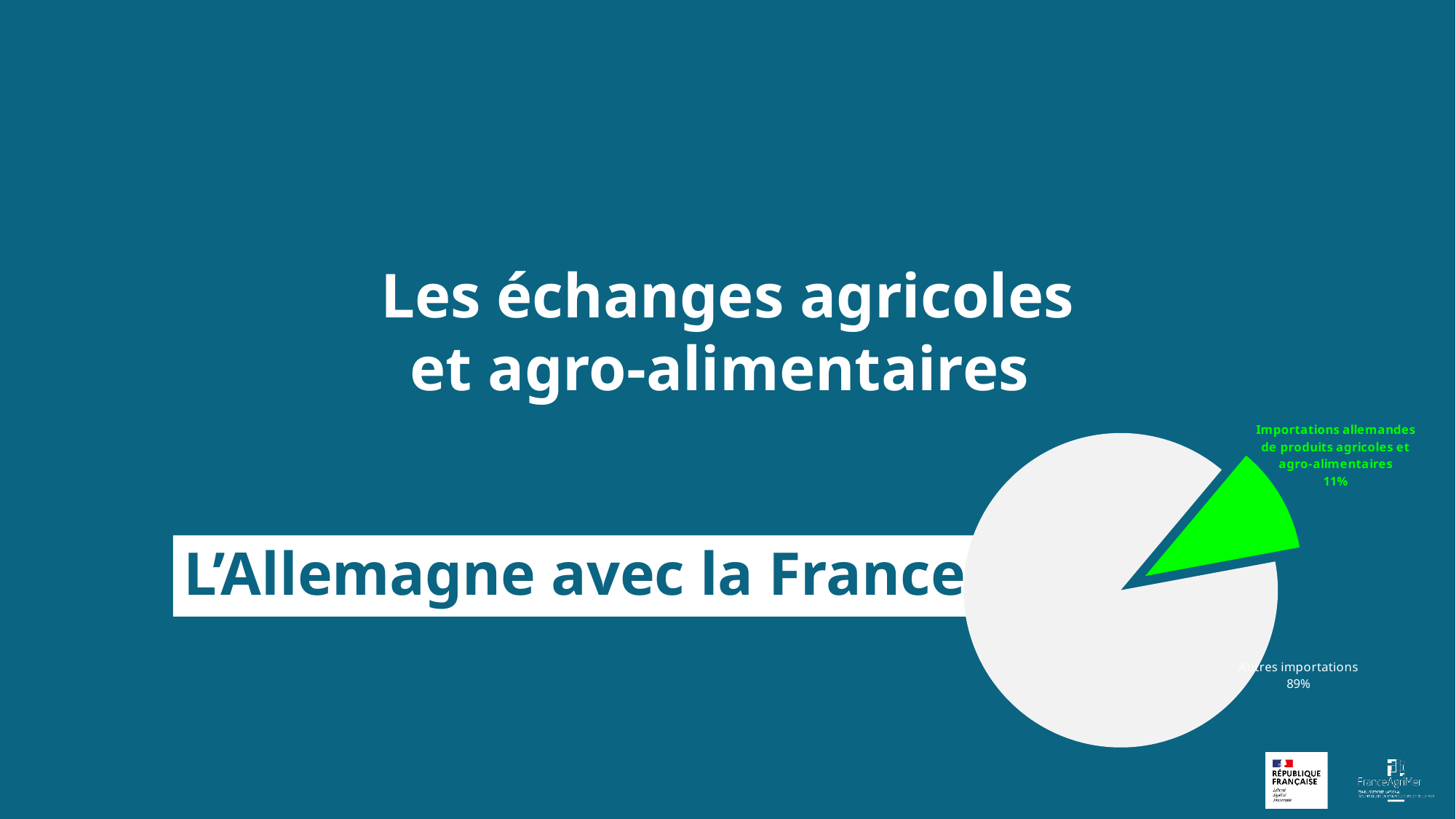
What kind of chart is shown on the slide? pie chart What share of the pie is labelled "Autres importations"? 89% What share of the pie is labelled "Importations allemandes de produits agricoles et agro-alimentaires"? 11% What colour is the slice for "Importations allemandes de produits agricoles et agro-alimentaires"? green How many slices does the pie chart have? 2 Which slice of the pie is the largest? Autres importations Which slice of the pie is the smallest? Importations allemandes de produits agricoles et agro-alimentaires What is the difference in percentage points between the "Autres importations" slice and the "Importations allemandes de produits agricoles et agro-alimentaires" slice? 78 percentage points Is the share for "Importations allemandes de produits agricoles et agro-alimentaires" greater or less than 50%? less Which is larger: the "Autres importations" slice or the "Importations allemandes de produits agricoles et agro-alimentaires" slice? Autres importations What colour is the "Autres importations" slice? light grey